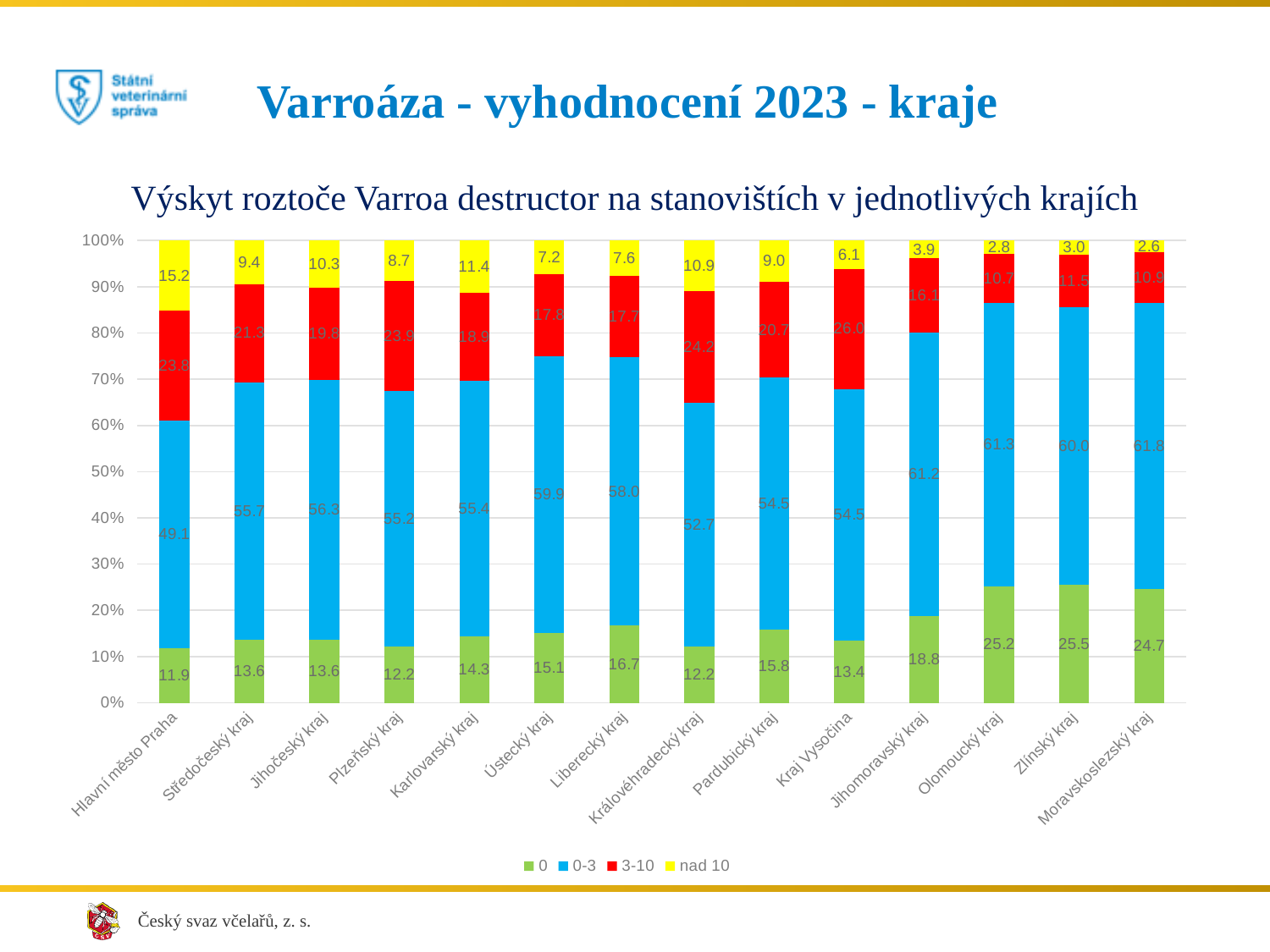
What is the value of the '0' segment for Zlínský kraj? 25.5 What is the value of the 'nad 10' segment for Hlavní město Praha? 15.2 How many regions (kraje) are shown on the x axis? 14 What is the difference between the 'nad 10' values for Hlavní město Praha and Středočeský kraj? 5.8 What kind of chart is shown on the slide? stacked bar chart What is the value of the '0-3' segment for Moravskoslezský kraj? 61.8 Which region has the highest 'nad 10' value? Hlavní město Praha Which has the larger '0-3' value, Ústecký kraj or Liberecký kraj? Ústecký kraj Which region has the lowest 'nad 10' value? Moravskoslezský kraj What is the value of the '0' segment for Jihomoravský kraj? 18.8 What is the title of the chart? Výskyt roztoče Varroa destructor na stanovištích v jednotlivých krajích How many series does the legend list? 4